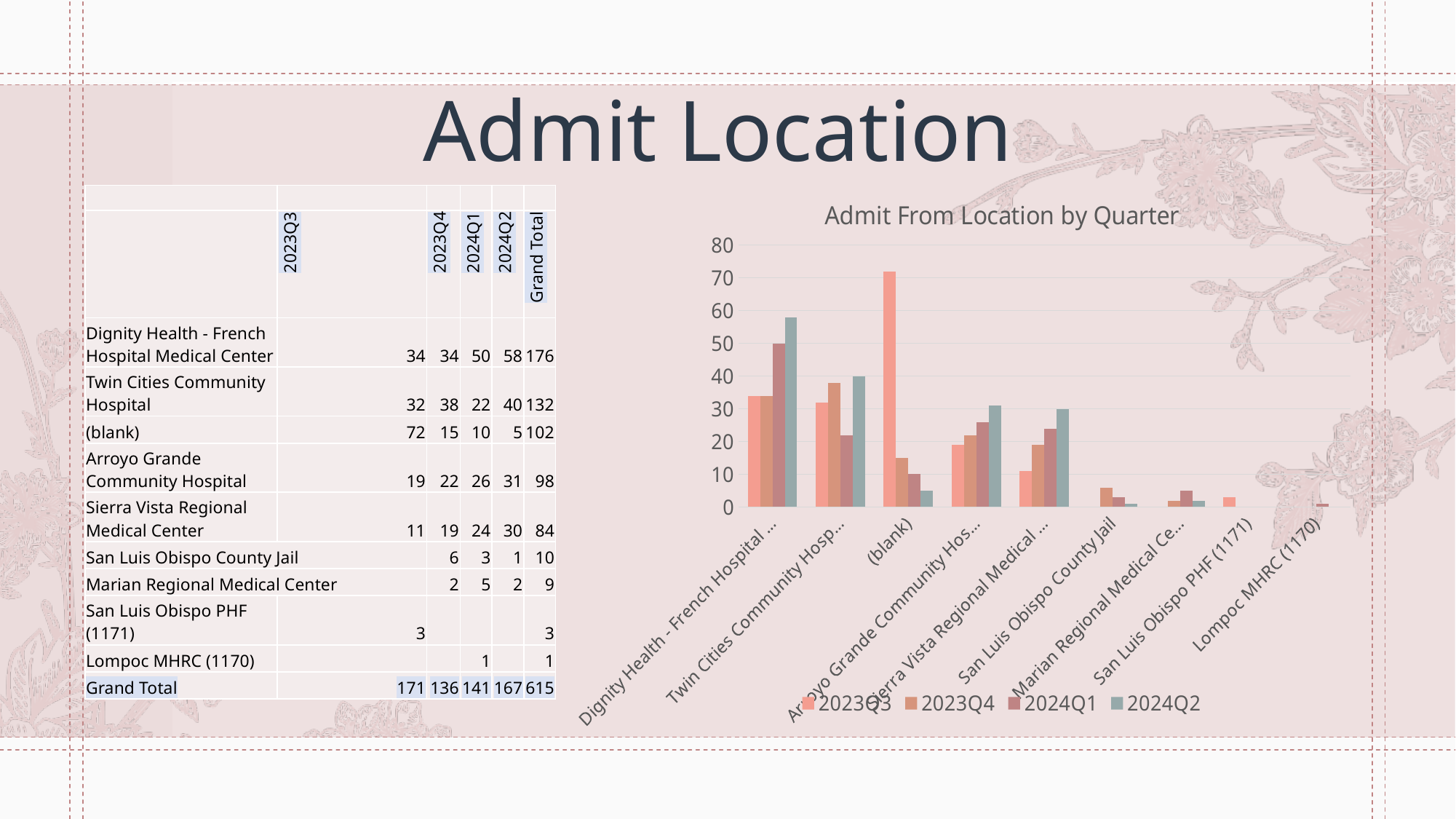
Which has the larger 2024Q2 value: Dignity Health - French Hospital Medical Center or Twin Cities Community Hospital? Dignity Health - French Hospital Medical Center What is the difference between the 2024Q2 and 2023Q3 values for Dignity Health - French Hospital Medical Center? 24 What is the 2024Q2 value for Dignity Health - French Hospital Medical Center? 58 What kind of chart is shown on the slide? bar chart Is the 2024Q2 value for Twin Cities Community Hospital greater or less than 30? greater Is the 2023Q3 value for (blank) greater or less than 70? greater What is the title of the chart? Admit From Location by Quarter Do the values for Sierra Vista Regional Medical Center rise or fall from 2023Q3 to 2024Q2? rise How many admit locations are plotted along the x axis of the chart? 9 How many series does the legend of the 'Admit From Location by Quarter' chart list? 4 Which admit location has the tallest 2023Q3 bar in the chart? (blank) What is the Grand Total for Twin Cities Community Hospital? 132